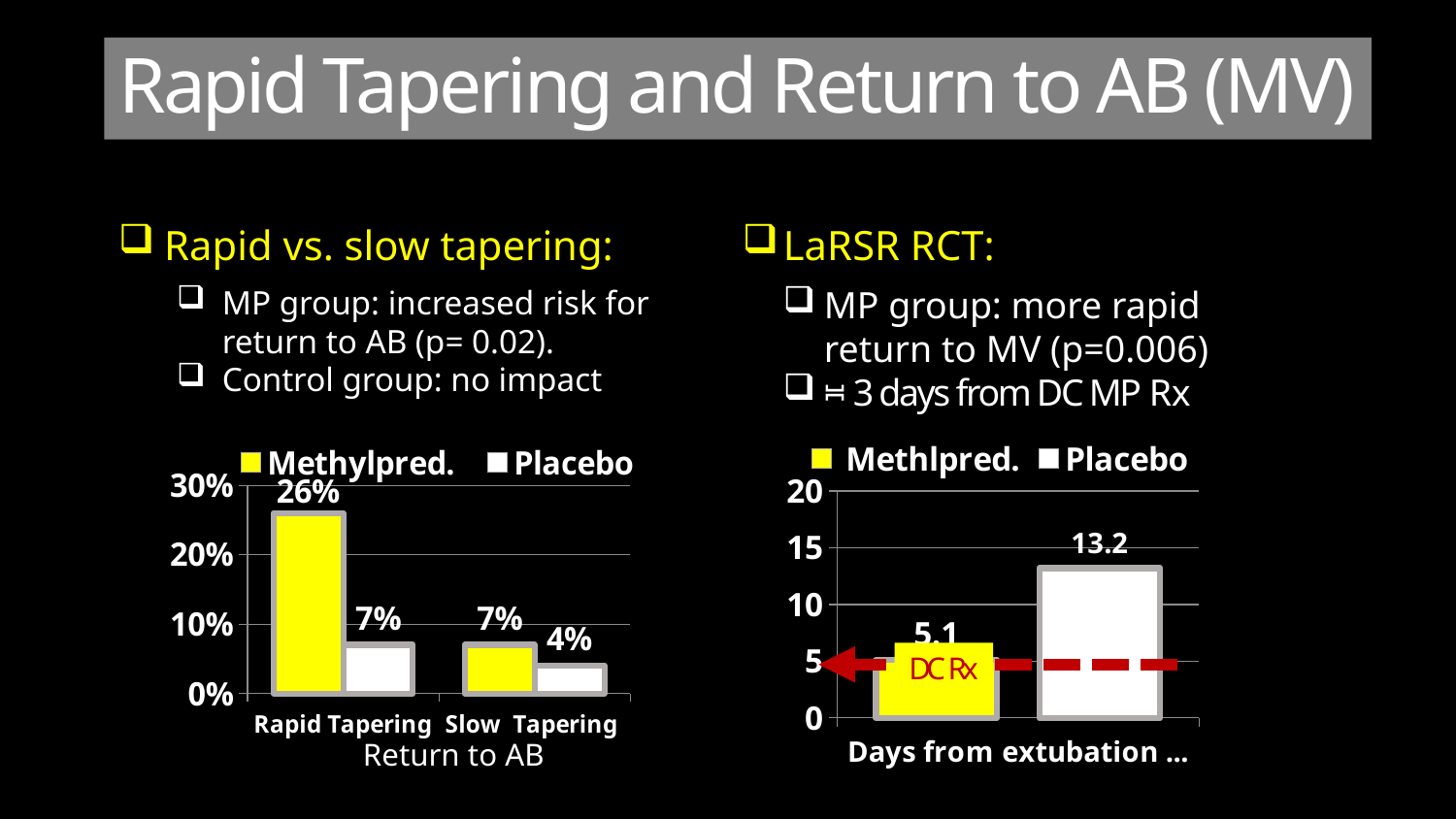
In the left chart (Return to AB), which bar is the highest? Methylpred., Rapid Tapering In the left chart (Return to AB), what is the value for Methylpred. in the Rapid Tapering category? 26% In the right chart (Days from extubation), what is the value for Methlpred.? 5.1 In the right chart (Days from extubation), what is the value for Placebo? 13.2 In the right chart (Days from extubation), what is the difference between the Placebo and Methlpred. values? 8.1 In the left chart (Return to AB), what is the value for Placebo in the Slow Tapering category? 4% In the left chart (Return to AB), how many categories are shown on the x axis? 2 In the left chart (Return to AB), how many series does the legend list? 2 What kind of chart is the right chart (Days from extubation)? Bar chart In the right chart (Days from extubation), which is larger, Methlpred. or Placebo? Placebo In the left chart (Return to AB), what is the value for Placebo in the Rapid Tapering category? 7% In the left chart (Return to AB), what is the difference between Methylpred. and Placebo in the Rapid Tapering category? 19%